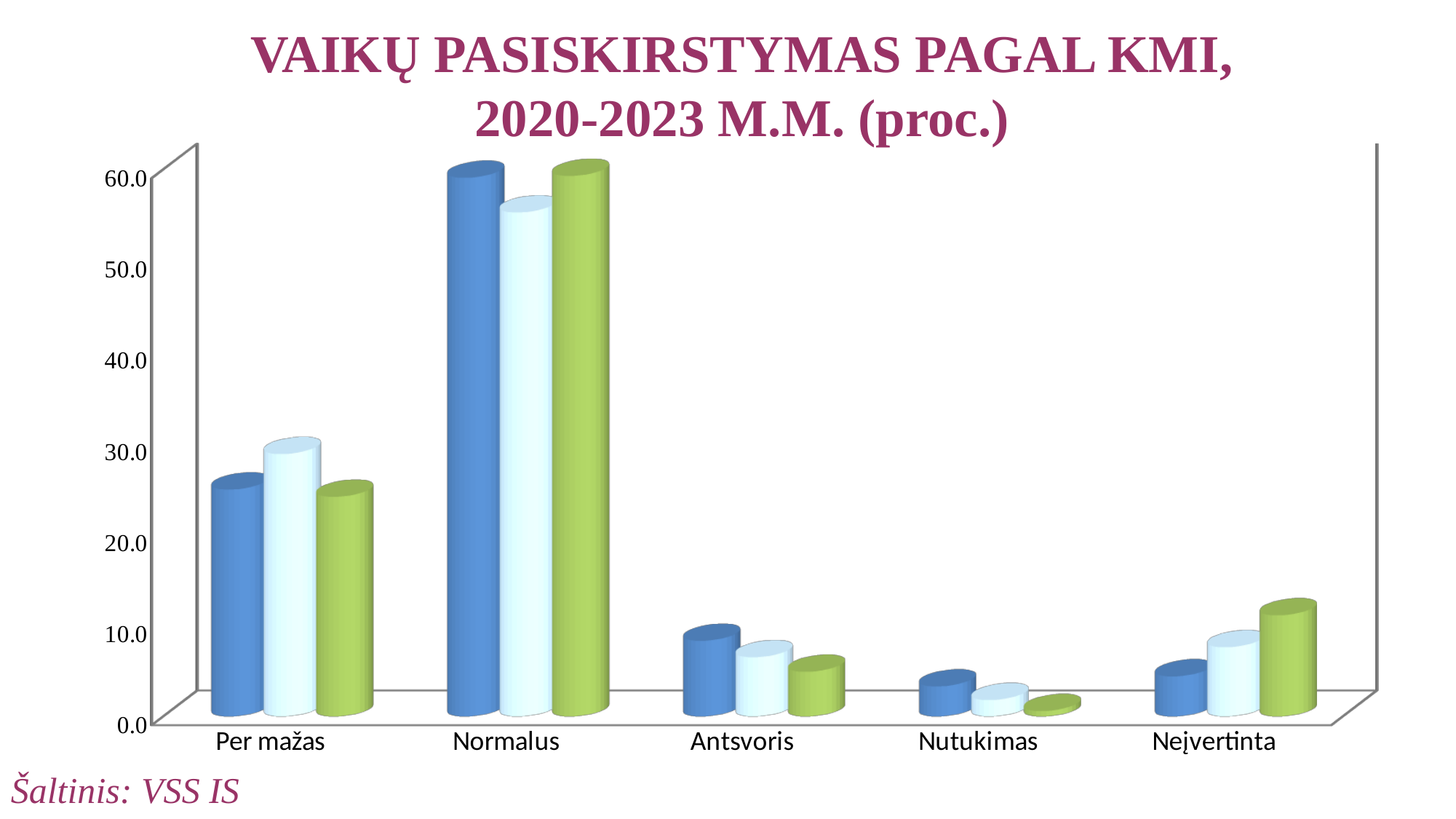
Which category has the highest bars in the chart? Normalus What is the title of the chart? VAIKŲ PASISKIRSTYMAS PAGAL KMI, 2020-2023 M.M. (proc.) Is the value of the green bar for Per mažas greater or less than 20? greater Is the value of the blue bar for Antsvoris greater or less than 10? less How many bars are shown for each category in the chart? 3 Is the value of the green bar for Nutukimas greater or less than 10? less Which category has the larger blue bar, Per mažas or Antsvoris? Per mažas Which category has the lowest bars in the chart? Nutukimas Which category has the larger green bar, Neįvertinta or Nutukimas? Neįvertinta What kind of chart is shown on the slide? bar chart How many categories are shown on the x axis of the chart? 5